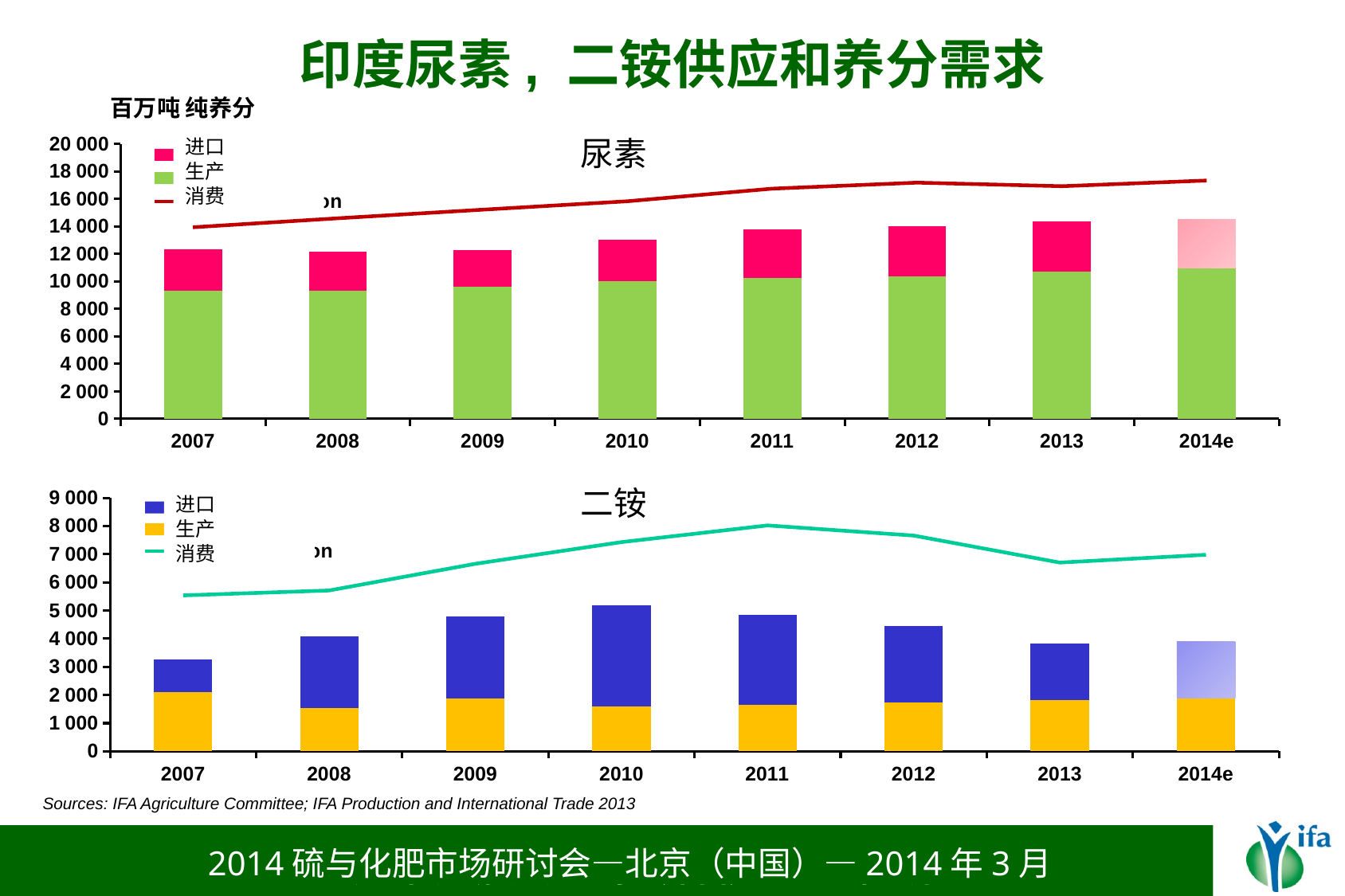
What kind of chart is the 尿素 chart? Stacked bar chart with a line In the 尿素 chart, does the 消费 line generally rise or fall from 2007 to 2014e? rise In the 二铵 chart, which colour represents 进口? Blue In the 二铵 chart, is the 消费 value for 2013 greater or less than 7 000? less In the 二铵 chart, which year has the lowest total bar (生产 plus 进口)? 2007 In the 二铵 chart, which year has the tallest total bar (生产 plus 进口)? 2010 In the 二铵 chart, which year has the highest 消费 value? 2011 In the 二铵 chart, is the 生产 value for 2008 greater or less than 2 000? less In the 尿素 chart, is the 生产 value for 2007 greater or less than 8 000? greater How many series does the legend of the 尿素 chart list? 3 How many years are shown on the x axis of the 二铵 chart? 8